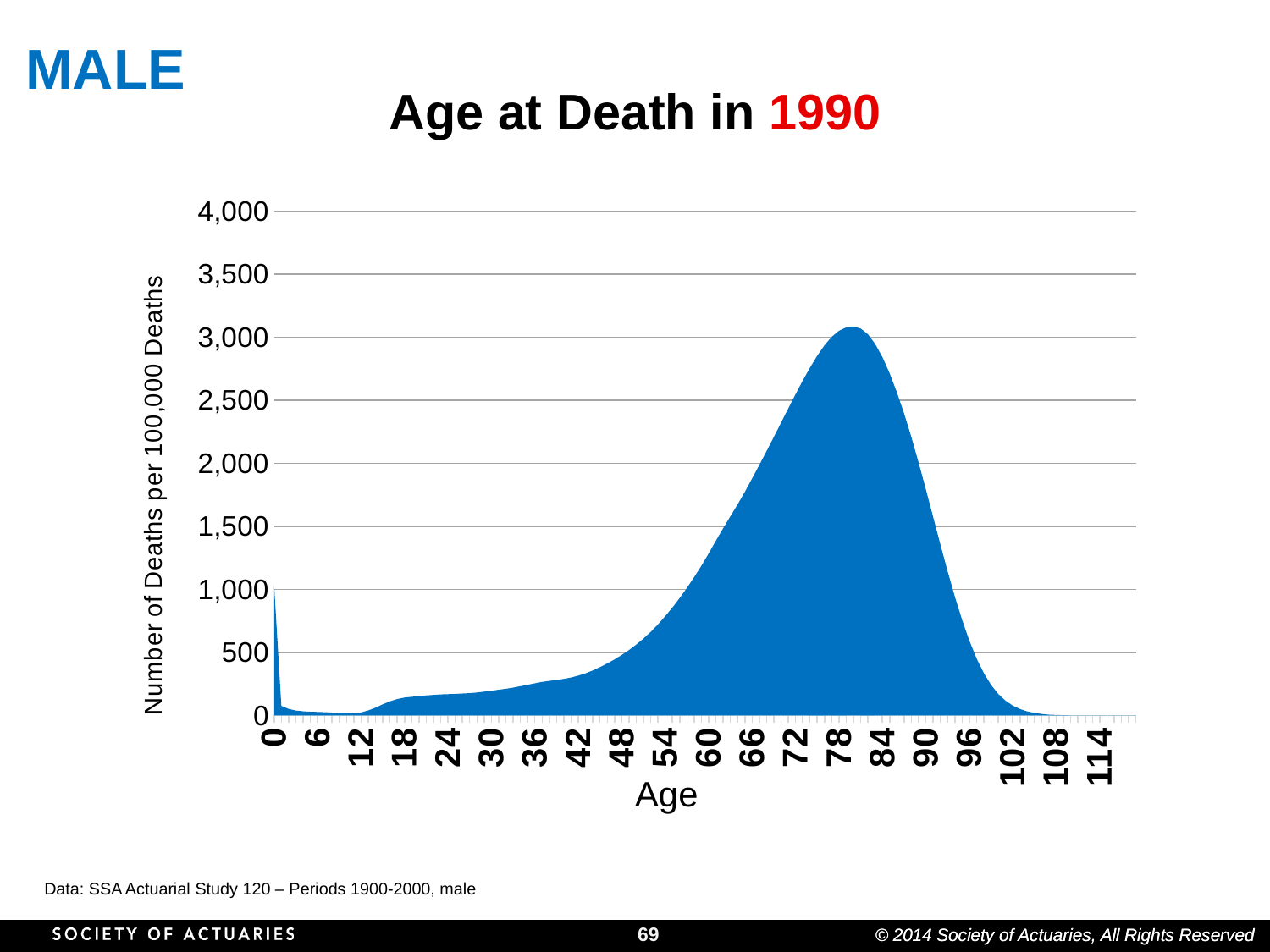
What kind of chart is shown on the slide? Area chart Is the value at age 42 greater or less than 500? less Is the value at age 72 greater or less than 2,000? greater Is the value at age 60 greater or less than 1,000? greater What is the title of the chart? Age at Death in 1990 How many age labels are shown on the x axis? 20 Do the values rise or fall as age increases from 60 to 78? rise Do the values rise or fall as age increases from 84 to 108? fall What is the label of the vertical axis? Number of Deaths per 100,000 Deaths